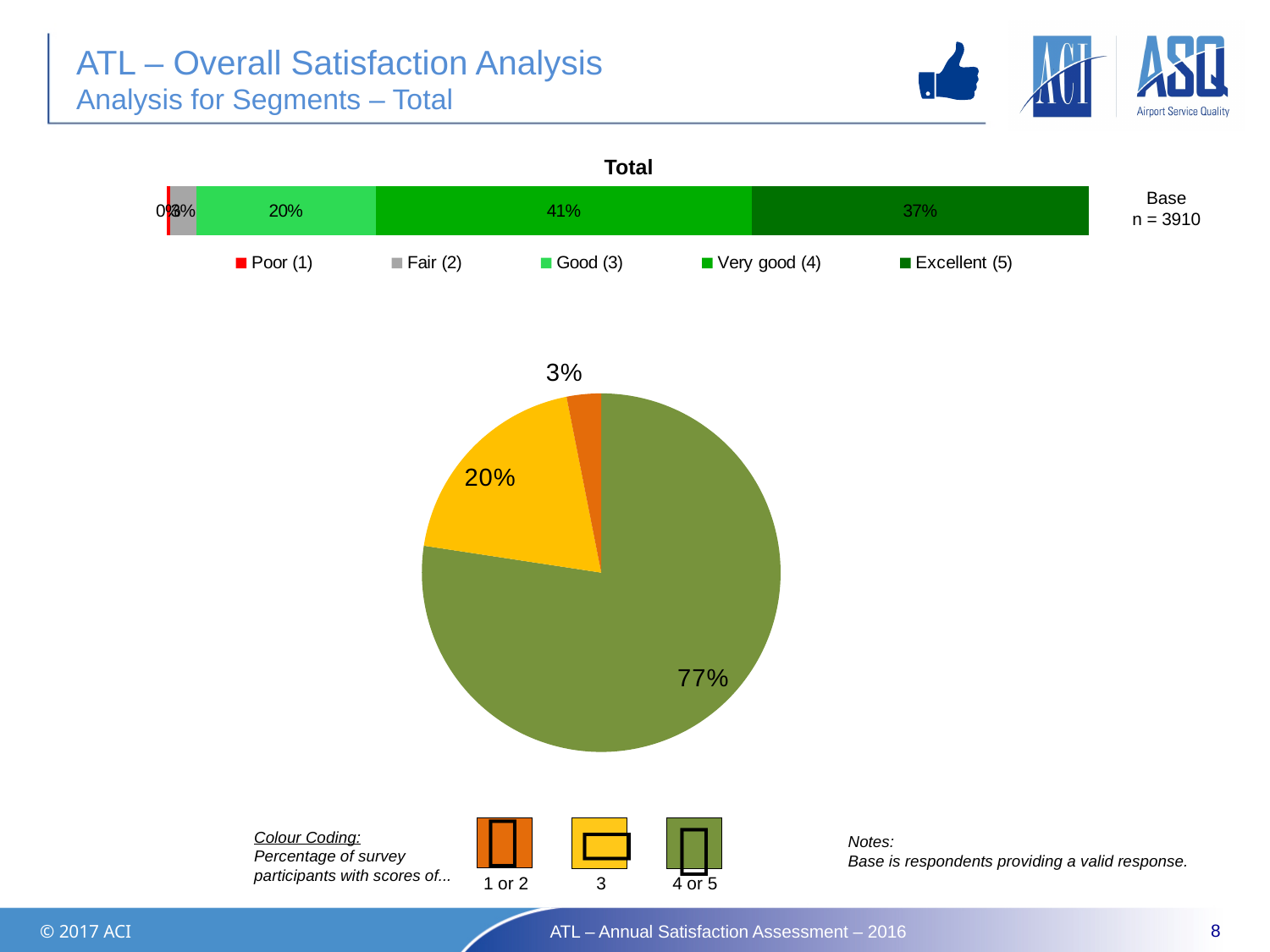
In the stacked bar chart titled "Total", which rating category has the largest share? Very good (4) In the stacked bar chart titled "Total", which is larger, Good (3) or Excellent (5)? Excellent (5) How many series does the legend of the stacked bar chart titled "Total" list? 5 In the pie chart, what percentage of participants gave scores of 4 or 5? 77% In the stacked bar chart titled "Total", what is the difference between the Very good (4) and Excellent (5) percentages? 4% In the pie chart, what percentage of participants gave a score of 3? 20% In the stacked bar chart titled "Total", what percentage is shown for Good (3)? 20% In the pie chart, which score group has the smallest slice? 1 or 2 What is the base (n) shown next to the stacked bar chart titled "Total"? n = 3910 What kind of chart is the lower chart on the slide? Pie chart In the stacked bar chart titled "Total", what percentage is shown for Excellent (5)? 37% In the stacked bar chart titled "Total", what percentage is shown for Very good (4)? 41%